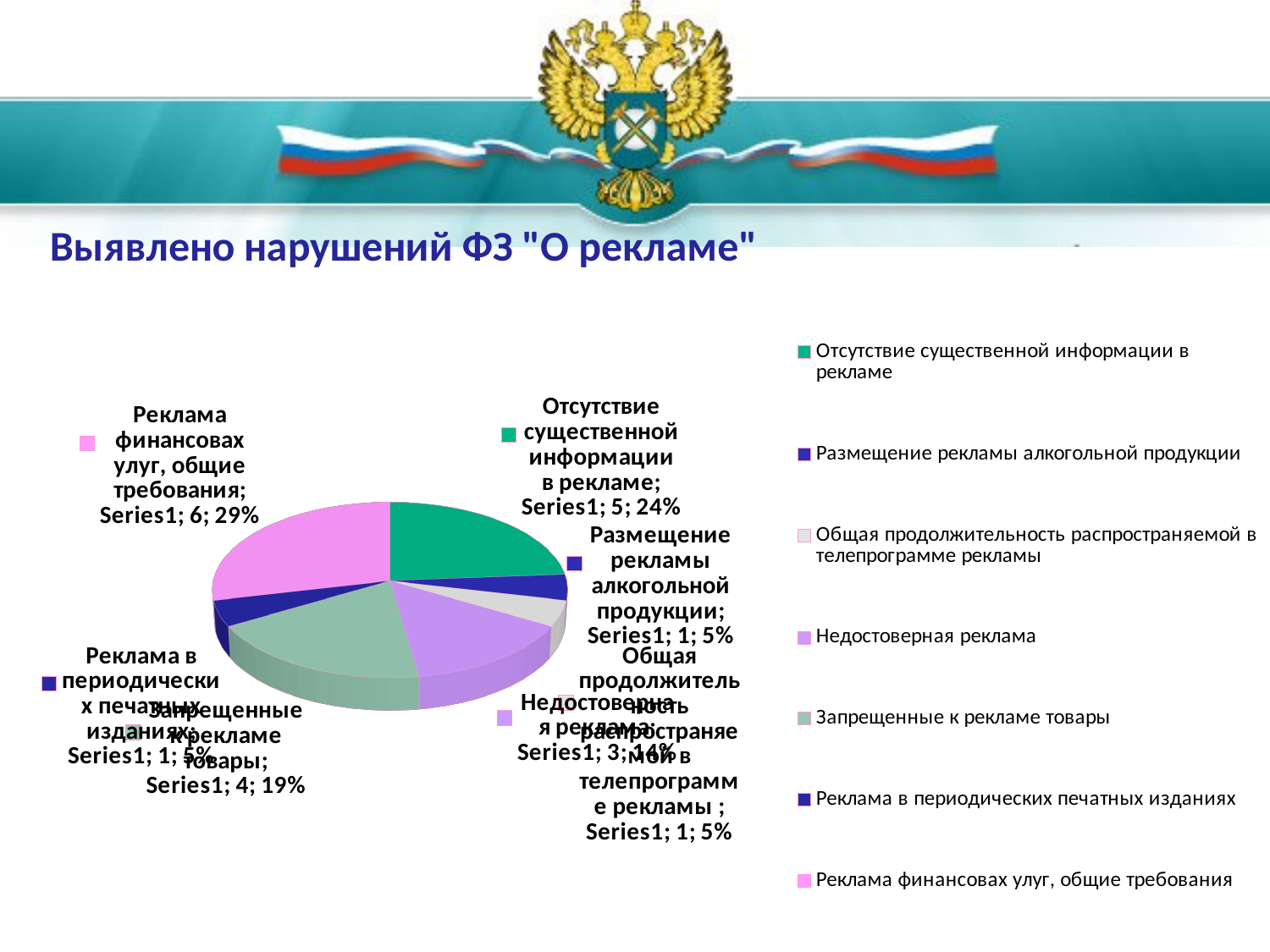
What is the value for "Запрещенные к рекламе товары"? 4 How many categories (slices) does the pie chart have? 7 What is the title of the chart on the slide? Выявлено нарушений ФЗ "О рекламе" What share of the pie does "Размещение рекламы алкогольной продукции" represent? 5% Which category has the largest slice of the pie? Реклама финансовах улуг, общие требования What share of the pie does "Запрещенные к рекламе товары" represent? 19% What is the value for "Отсутствие существенной информации в рекламе"? 5 What is the difference between the values for "Реклама финансовах улуг, общие требования" and "Недостоверная реклама"? 3 What is the value for "Реклама финансовах улуг, общие требования"? 6 Which is larger: the value for "Отсутствие существенной информации в рекламе" or for "Запрещенные к рекламе товары"? Отсутствие существенной информации в рекламе What is the value for "Недостоверная реклама"? 3 What kind of chart is shown on the slide? pie chart